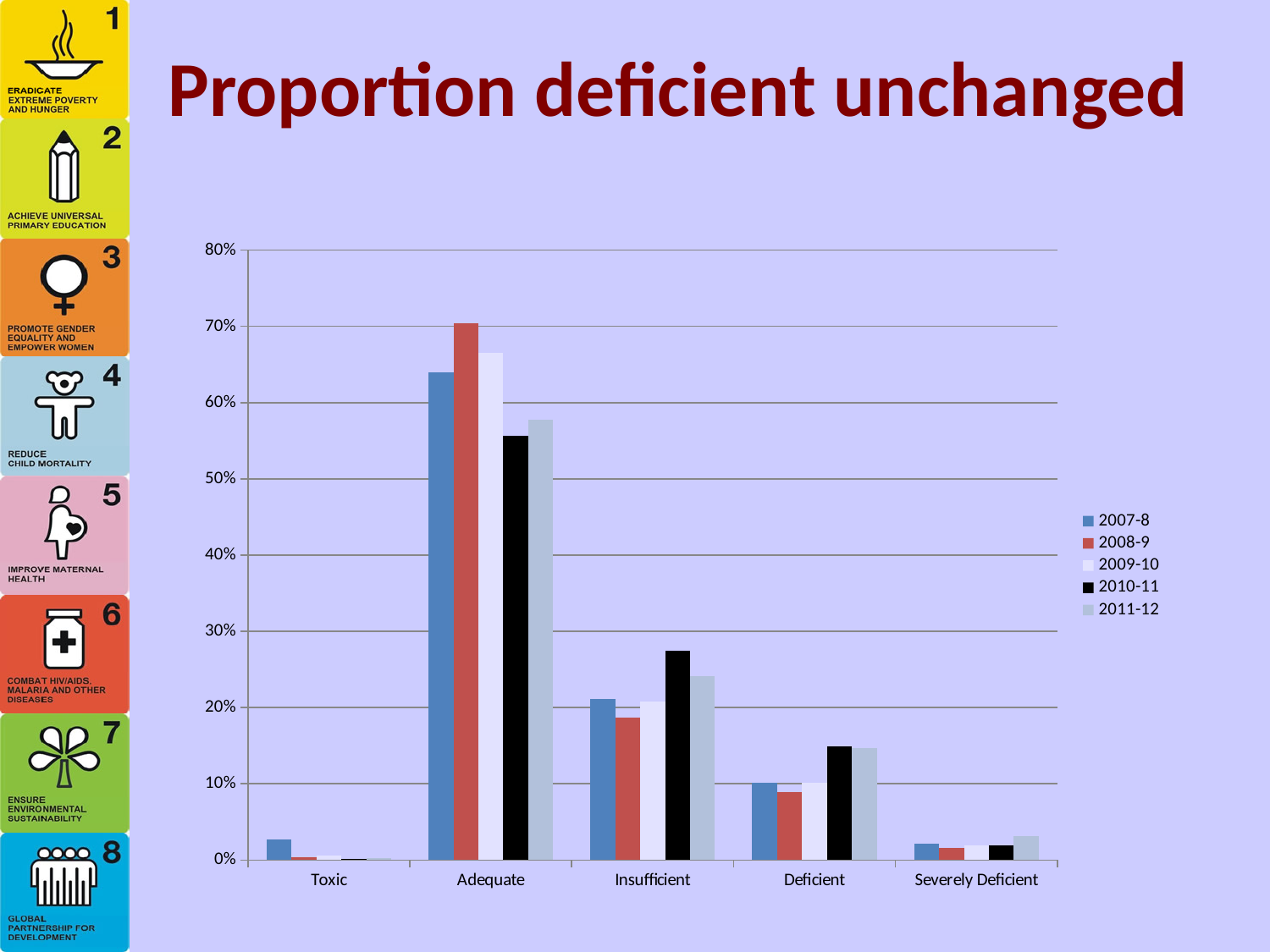
Within the Adequate category, which series has the highest bar? 2008-9 How many series does the chart's legend list? 5 Is the 2010-11 value for Deficient greater or less than 10%? greater Within the Adequate category, which series has the lowest bar? 2010-11 Is the 2007-8 value for Adequate greater or less than 60%? greater Is the 2010-11 value for Adequate greater or less than 60%? less Which category has the highest value for the 2008-9 series? Adequate How many categories are shown on the x axis of the chart? 5 In the Insufficient category, which is larger: the 2010-11 value or the 2011-12 value? 2010-11 Within the Toxic category, which series has the highest bar? 2007-8 What kind of chart is shown on the slide? bar chart